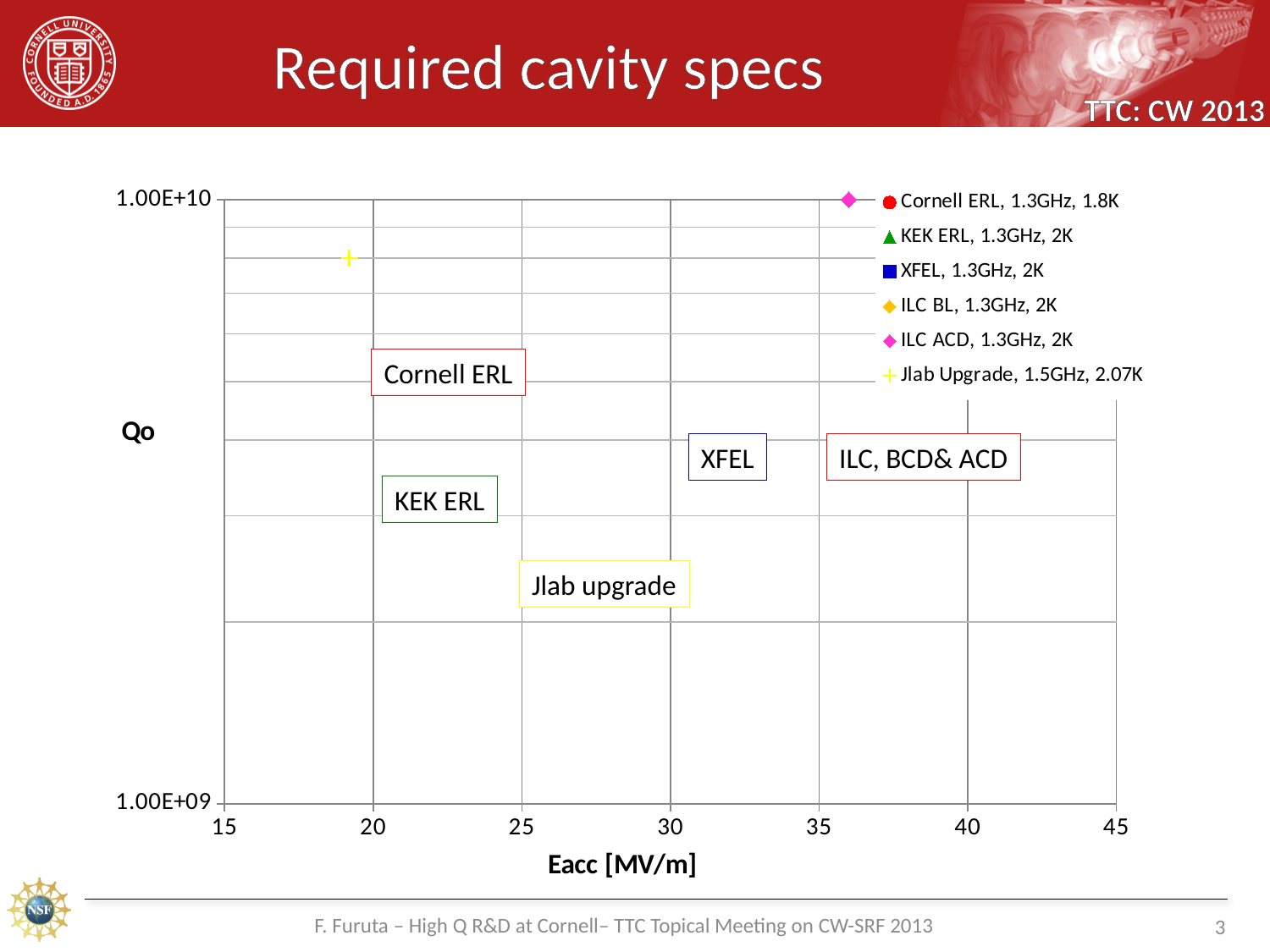
Which point has the higher Eacc, ILC ACD, 1.3GHz, 2K or Jlab Upgrade, 1.5GHz, 2.07K? ILC ACD, 1.3GHz, 2K Is the Eacc value for the ILC ACD, 1.3GHz, 2K point greater or less than 35? greater What is the Qo value of the ILC ACD, 1.3GHz, 2K point? 1.00E+10 Is the Qo value for the Jlab Upgrade, 1.5GHz, 2.07K point greater or less than 1.00E+09? greater According to the legend, what temperature is listed for the Cornell ERL series? 1.8K How many series does the legend list? 6 Which point has the higher Qo, ILC ACD, 1.3GHz, 2K or Jlab Upgrade, 1.5GHz, 2.07K? ILC ACD, 1.3GHz, 2K What kind of chart is shown on the slide? scatter chart What is the label of the x axis? Eacc [MV/m] Is the Eacc value for the Jlab Upgrade, 1.5GHz, 2.07K point greater or less than 20? less